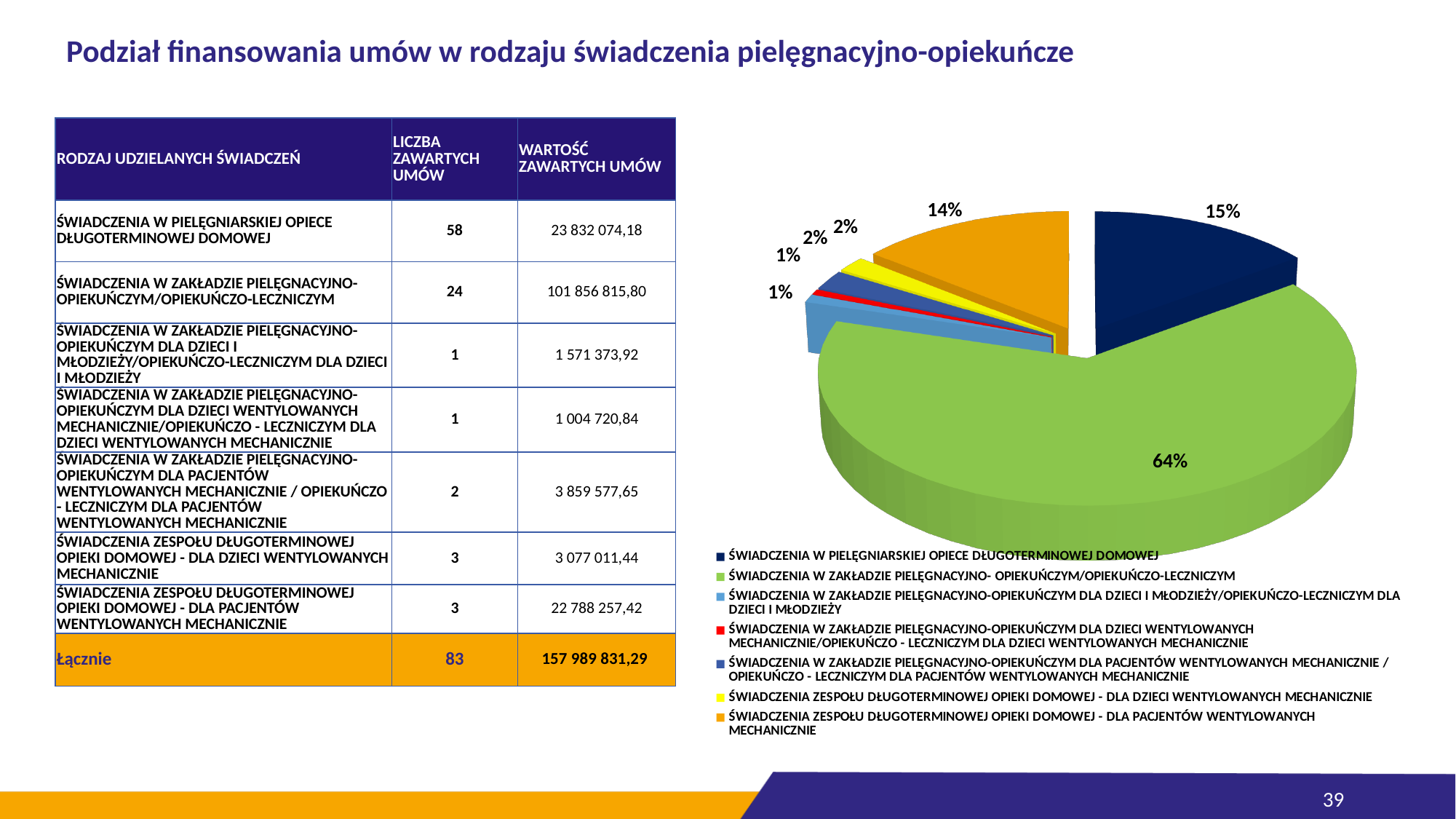
What is the difference in percentage points between the 64% slice and the 15% slice in the pie chart? 49 What share of the pie does ŚWIADCZENIA W PIELĘGNIARSKIEJ OPIECE DŁUGOTERMINOWEJ DOMOWEJ have? 15% What kind of chart is shown on the slide? pie chart How many slices does the pie chart have? 7 What colour is the slice for ŚWIADCZENIA ZESPOŁU DŁUGOTERMINOWEJ OPIEKI DOMOWEJ - DLA PACJENTÓW WENTYLOWANYCH MECHANICZNIE? orange What share of the pie does ŚWIADCZENIA ZESPOŁU DŁUGOTERMINOWEJ OPIEKI DOMOWEJ - DLA PACJENTÓW WENTYLOWANYCH MECHANICZNIE have? 14% How many entries does the pie chart's legend list? 7 What colour is the largest slice of the pie chart? green What share of the pie does ŚWIADCZENIA W ZAKŁADZIE PIELĘGNACYJNO-OPIEKUŃCZYM/OPIEKUŃCZO-LECZNICZYM have? 64% Which is larger in the pie chart: the slice for ŚWIADCZENIA W PIELĘGNIARSKIEJ OPIECE DŁUGOTERMINOWEJ DOMOWEJ or the slice for ŚWIADCZENIA ZESPOŁU DŁUGOTERMINOWEJ OPIEKI DOMOWEJ - DLA PACJENTÓW WENTYLOWANYCH MECHANICZNIE? ŚWIADCZENIA W PIELĘGNIARSKIEJ OPIECE DŁUGOTERMINOWEJ DOMOWEJ Which category has the largest slice of the pie chart? ŚWIADCZENIA W ZAKŁADZIE PIELĘGNACYJNO-OPIEKUŃCZYM/OPIEKUŃCZO-LECZNICZYM What is the combined share of the two largest slices in the pie chart (64% and 15%)? 79%